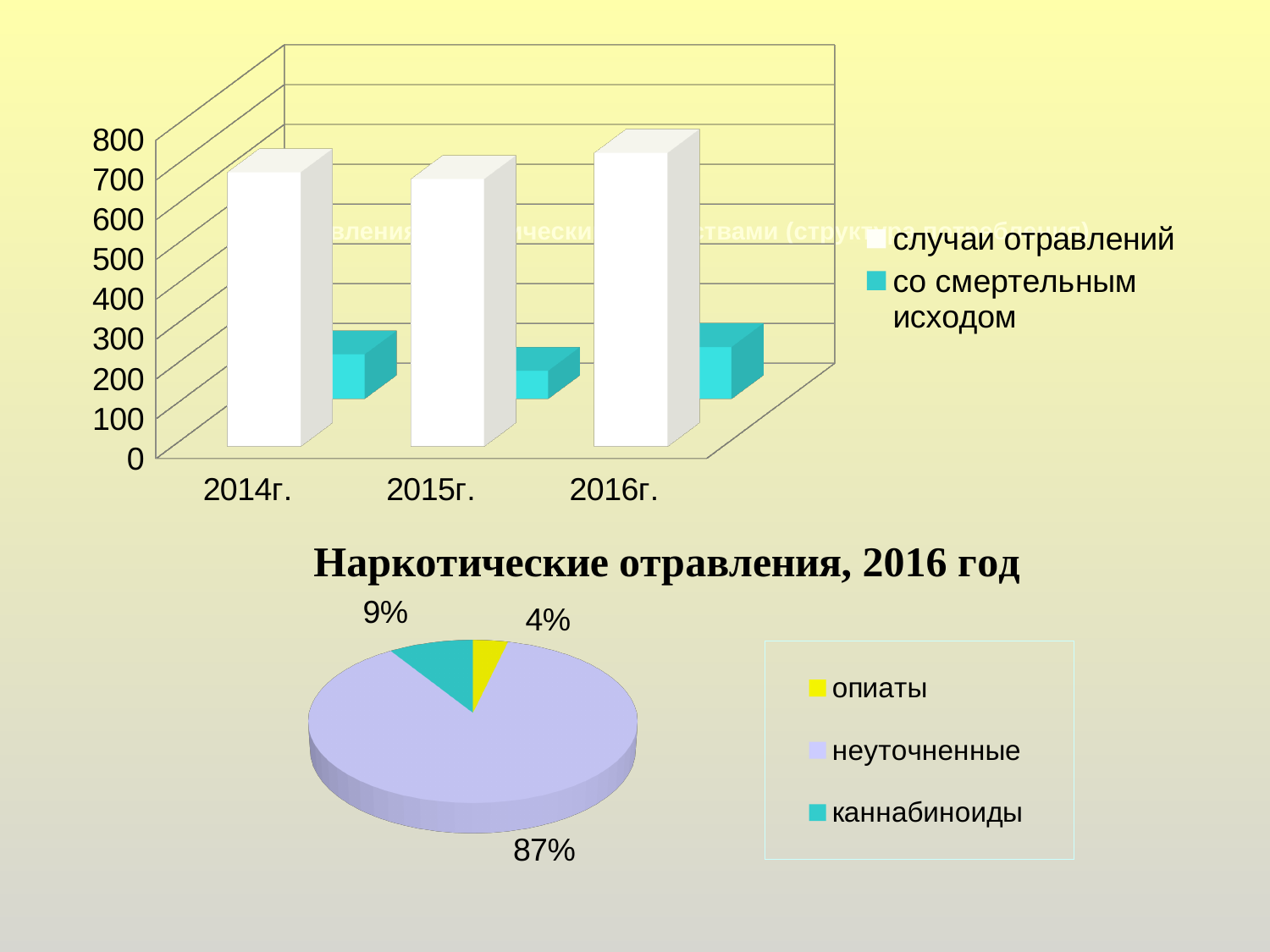
In the top bar chart, is the value for 'со смертельным исходом' in 2015г. greater or less than 400? less In the pie chart 'Наркотические отравления, 2016 год', which category has the smallest slice? опиаты In the pie chart 'Наркотические отравления, 2016 год', what share is labelled for неуточненные? 87% In the pie chart 'Наркотические отравления, 2016 год', which category has the largest slice? неуточненные What kind of chart is the top chart on the slide? bar chart In the top bar chart, which year has the tallest bar for 'случаи отравлений'? 2016г. In the pie chart 'Наркотические отравления, 2016 год', what share is labelled for опиаты? 4% In the pie chart 'Наркотические отравления, 2016 год', what share is labelled for каннабиноиды? 9% In the pie chart 'Наркотические отравления, 2016 год', what is the difference in percentage points between каннабиноиды and опиаты? 5 In the pie chart 'Наркотические отравления, 2016 год', how many categories does the legend list? 3 In the top bar chart, how many series does the legend list? 2 What kind of chart is the bottom chart on the slide? pie chart